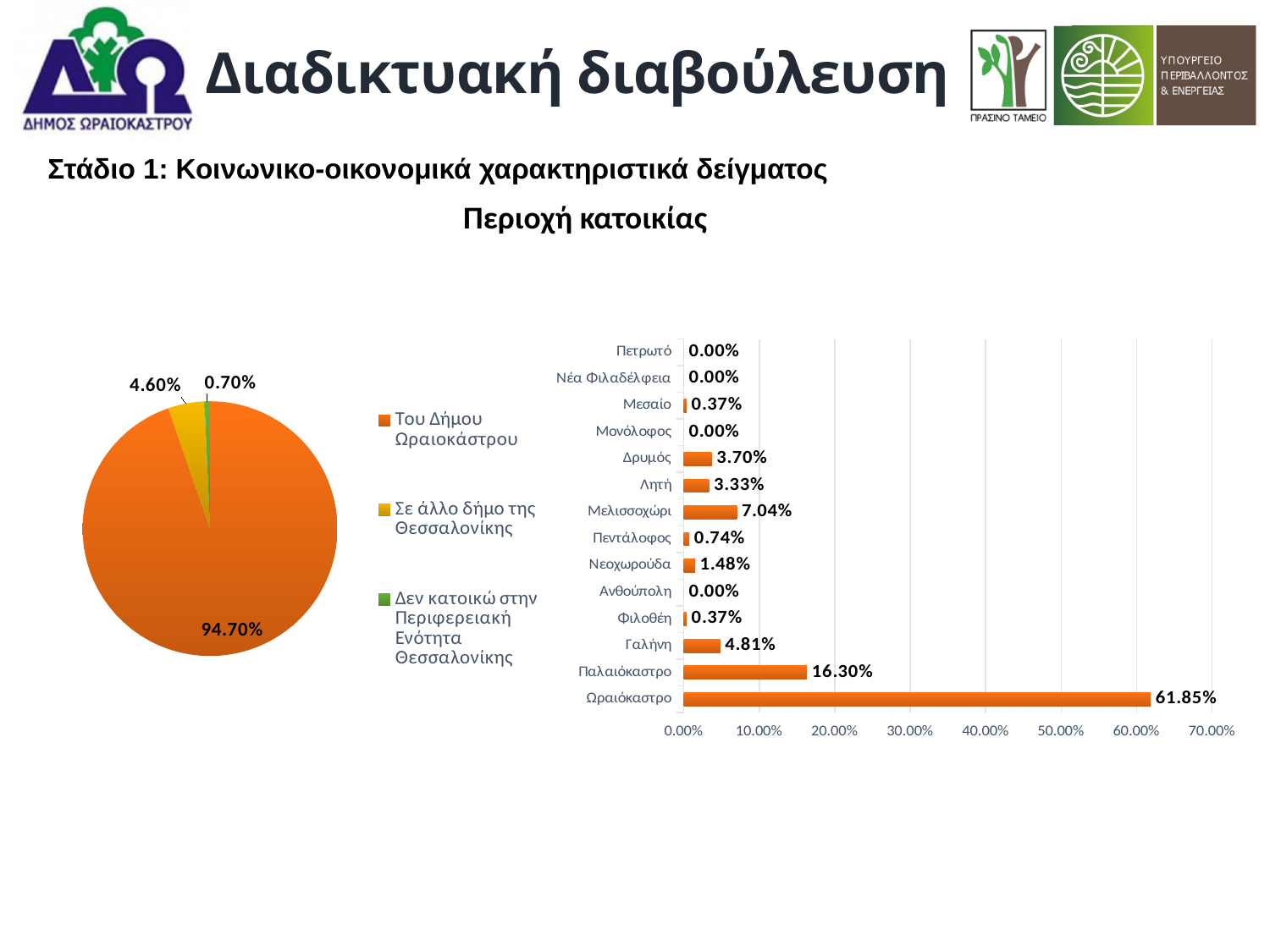
How many categories are shown in the bar chart on the right? 14 How many entries does the legend of the pie chart on the left list? 3 In the pie chart on the left, what is the value for Σε άλλο δήμο της Θεσσαλονίκης? 4.60% In the pie chart on the left, what share is labelled for Του Δήμου Ωραιοκάστρου? 94.70% What kind of chart is the chart on the right of the slide? bar chart In the bar chart on the right, which is larger, the value for Γαλήνη or the value for Δρυμός? Γαλήνη In the bar chart on the right, what is the difference between the values for Ωραιόκαστρο and Παλαιόκαστρο? 45.55% In the bar chart on the right, which category has the highest value? Ωραιόκαστρο In the bar chart on the right, what is the value for Μελισσοχώρι? 7.04% In the pie chart on the left, which category has the smallest slice? Δεν κατοικώ στην Περιφερειακή Ενότητα Θεσσαλονίκης In the bar chart on the right, what is the value for Παλαιόκαστρο? 16.30% In the bar chart on the right, how many categories have a value of 0.00%? 4